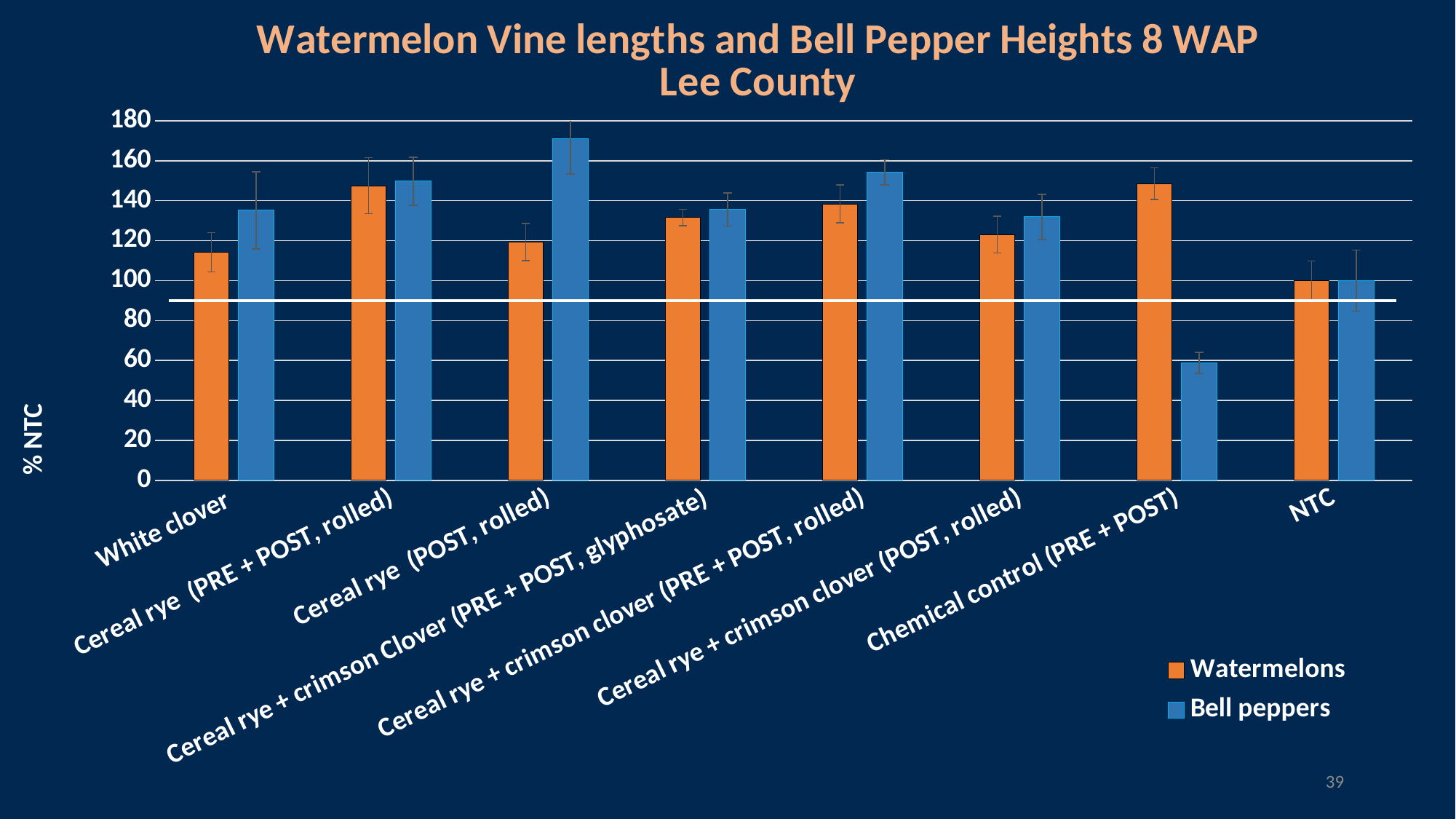
For White clover, which series has the larger value, Watermelons or Bell peppers? Bell peppers Is the Bell peppers value for Chemical control (PRE + POST) greater or less than 80? less Which treatment has the lowest Bell peppers value? Chemical control (PRE + POST) What kind of chart is shown on the slide? Bar chart What is the label of the y axis? % NTC Is the Watermelons value for Cereal rye (POST, rolled) greater or less than 140? less Is the Bell peppers value for Cereal rye (POST, rolled) greater or less than 160? greater Which treatment has the highest Bell peppers value? Cereal rye (POST, rolled) How many treatment categories are shown on the x axis? 8 For Chemical control (PRE + POST), which series has the larger value, Watermelons or Bell peppers? Watermelons How many series does the legend list? 2